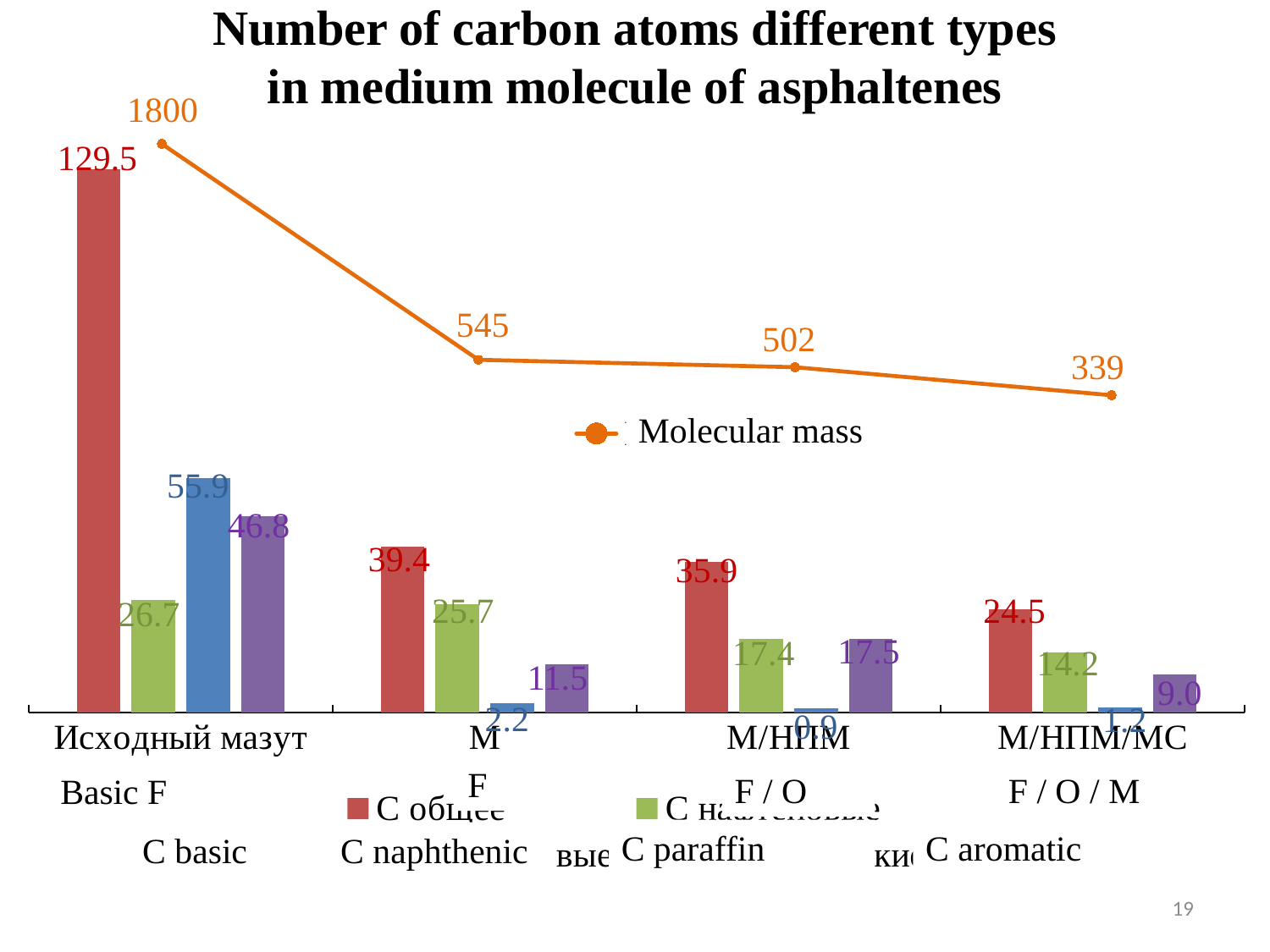
What is the Molecular mass value for the Basic F category? 1800 Which category has the lowest Molecular mass? F / O / M Which is larger, the C naphthenic value for Basic F or for F? Basic F Which category has the highest C basic value? Basic F What is the difference between the C basic and C naphthenic values for Basic F? 102.8 What is the difference between the Molecular mass for F and for F / O? 43 What is the C aromatic value for the F / O / M category? 9.0 What is the C paraffin value for the F category? 2.2 How many categories are shown on the x axis? 4 Does the Molecular mass line rise or fall from Basic F to F / O / M? Fall What is the C basic value for the F / O category? 35.9 What colour is the Molecular mass line? Orange